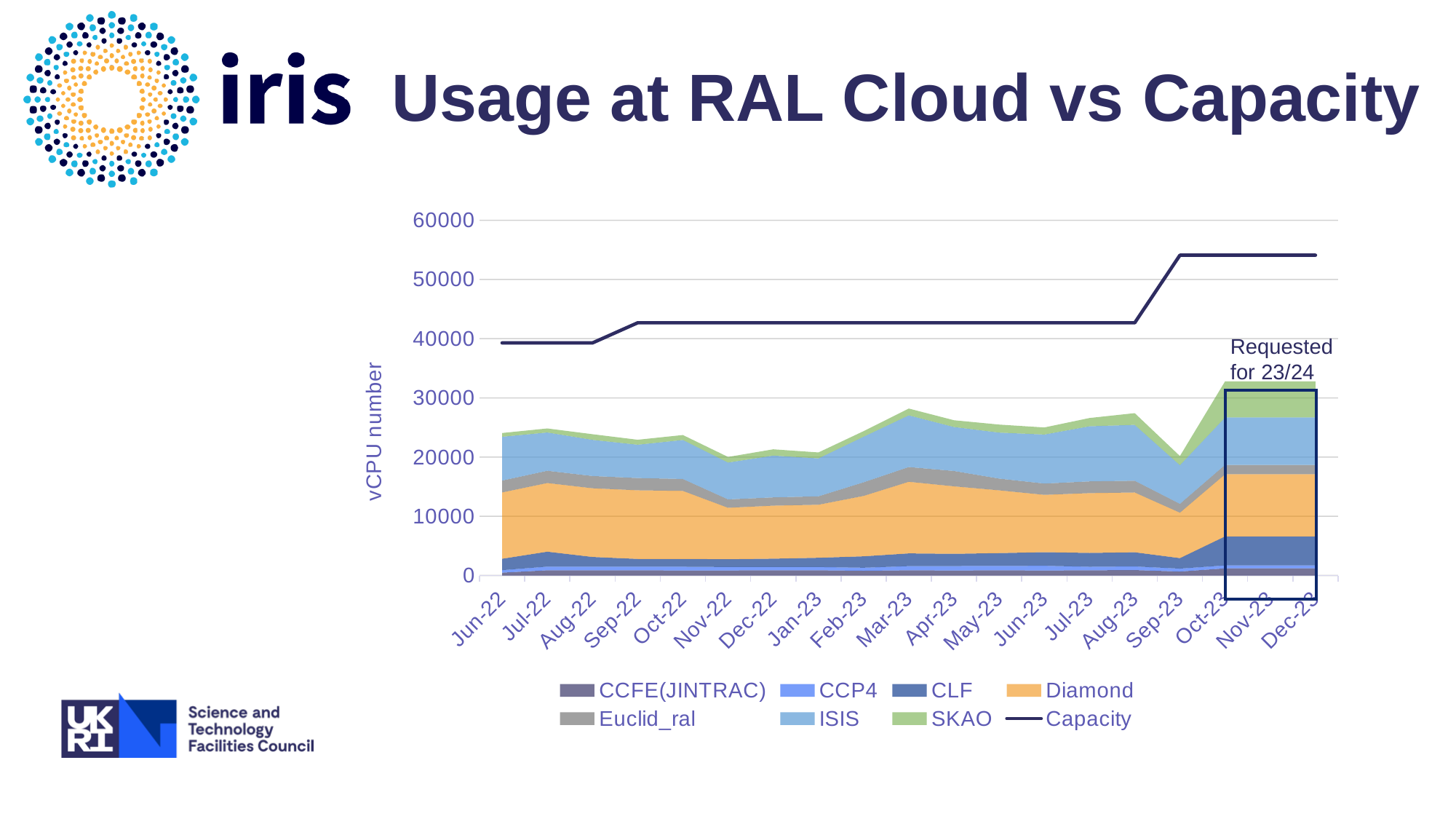
Is the Capacity value for Jan-23 greater or less than 40000? greater What is the label on the y axis? vCPU number Does the Capacity line rise or fall from Jun-22 to Dec-23? rise What does the annotation above the boxed region at the right of the chart say? Requested for 23/24 Is the Capacity value for Dec-23 greater or less than 50000? greater How many series does the legend list? 8 How many months are shown along the x axis? 19 Is the total usage for Nov-22 greater or less than 30000? less Which is larger, the Capacity value for Dec-23 or for Jun-22? Dec-23 What kind of chart is shown on the slide? Stacked area chart with a line Which is larger, the total usage for Mar-23 or for Nov-22? Mar-23